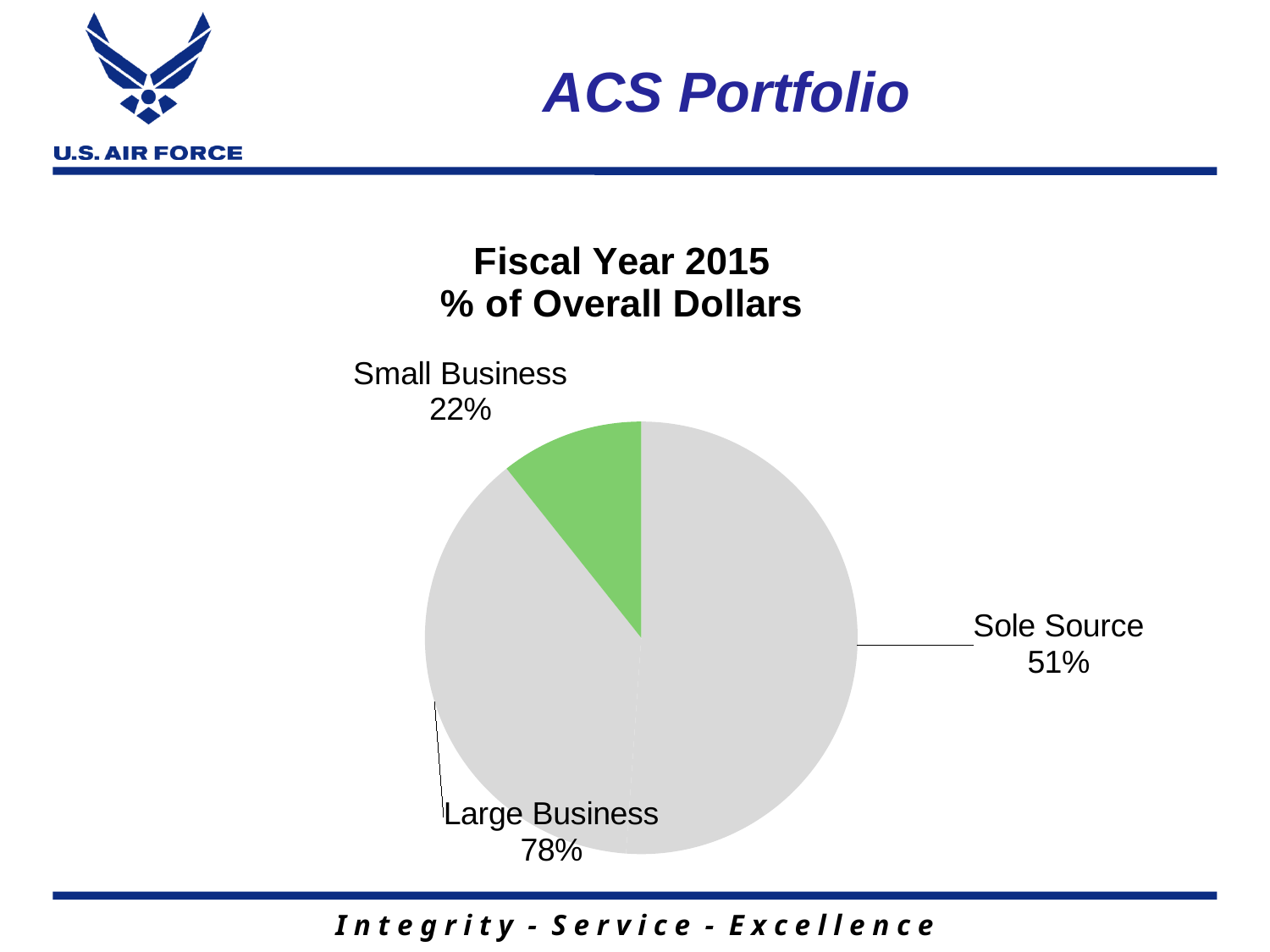
What colour is the Small Business slice of the pie? Green What percentage of overall dollars is attributed to Small Business? 22% Which category has the smallest share of overall dollars? Small Business What is the difference in percentage points between Large Business and Small Business? 56 percentage points What percentage is labelled for Sole Source on the pie chart? 51% What percentage of overall dollars is attributed to Large Business? 78% What is the title of the chart? Fiscal Year 2015 % of Overall Dollars What kind of chart is shown on the slide? Pie chart Which is larger, the Sole Source percentage or the Small Business percentage? Sole Source What do the Small Business and Large Business shares add up to? 100%